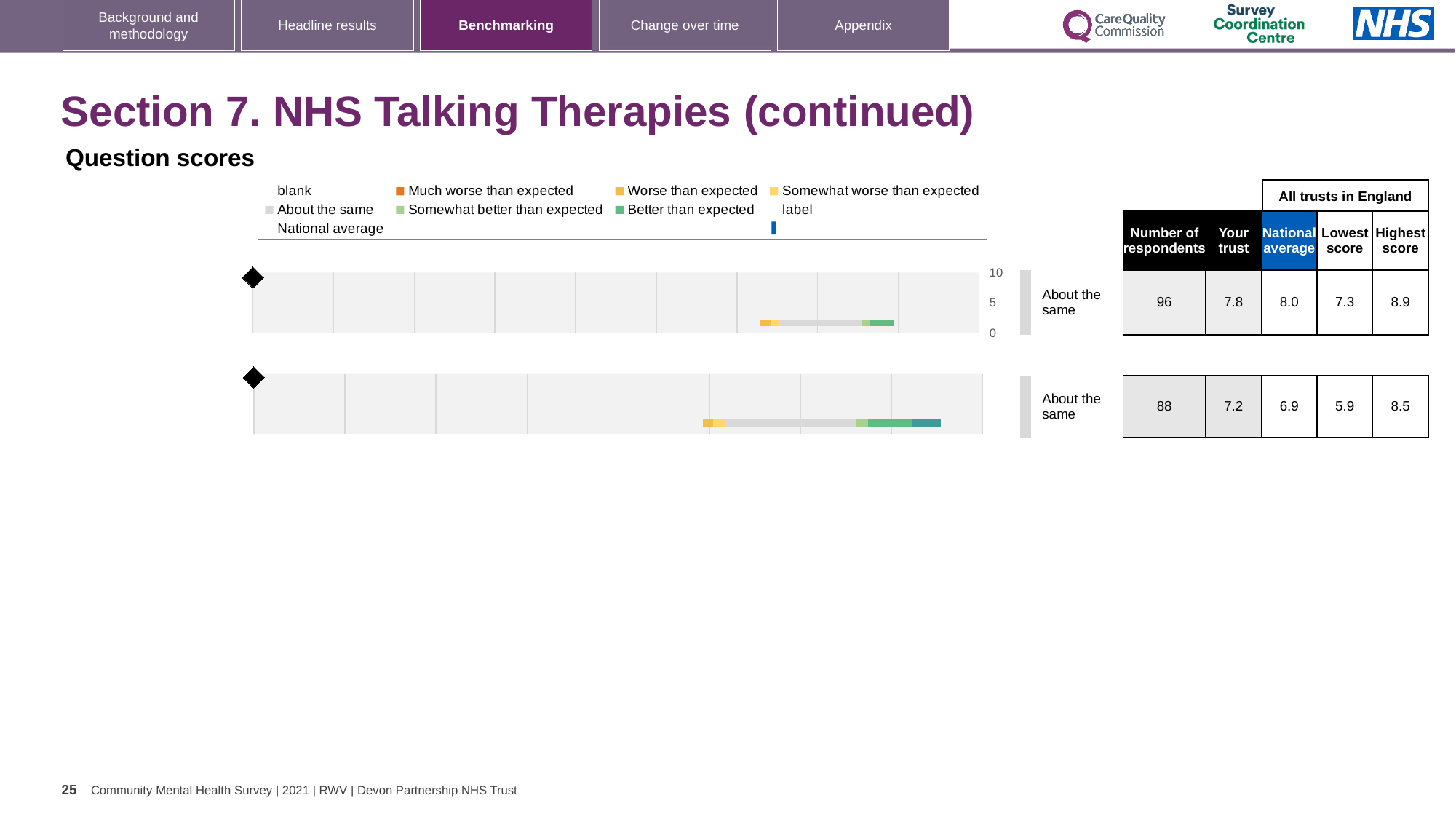
In the top chart's table, what is the national average score? 8.0 For the bottom chart, what is the difference between the highest score (8.5) and the lowest score (5.9)? 2.6 In the top chart's table, how many respondents are listed? 96 What kind of chart is used to show the question scores on this slide? bar chart For the bottom chart, which is larger: the 'Your trust' score or the national average? Your trust For the top chart, what is the difference between the highest score (8.9) and the lowest score (7.3)? 1.6 In the top chart's table, what is the 'Your trust' score? 7.8 What benchmark category label is shown next to both charts? About the same For the top chart, which is larger: the 'Your trust' score or the national average? National average How many question-score charts are shown on the slide? 2 In the bottom chart's table, what is the 'Your trust' score? 7.2 In the bottom chart's table, what is the lowest score among all trusts in England? 5.9